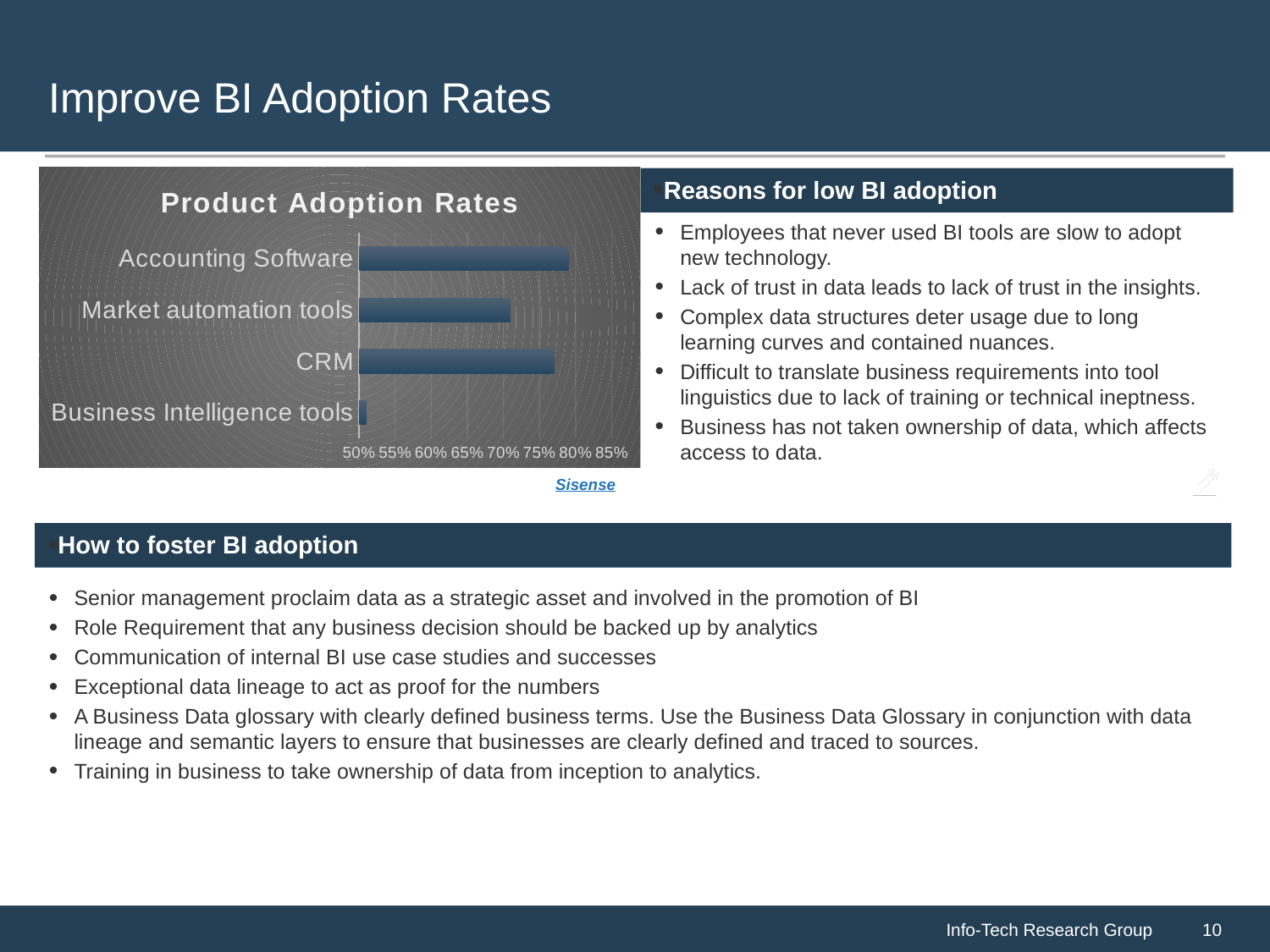
Is the value for Market automation tools greater or less than 75%? less Which category has the lowest adoption rate in the Product Adoption Rates chart? Business Intelligence tools How many product categories are plotted in the Product Adoption Rates chart? 4 What is the title of the chart on the slide? Product Adoption Rates What type of chart is shown under the title "Product Adoption Rates"? bar chart Which has a higher adoption rate, CRM or Market automation tools? CRM Is the value for CRM greater or less than 70%? greater Which has a higher adoption rate, Market automation tools or Accounting Software? Accounting Software Is the value for Business Intelligence tools greater or less than 55%? less What is the highest value shown on the horizontal axis of the Product Adoption Rates chart? 85% Which has a higher adoption rate, Accounting Software or Business Intelligence tools? Accounting Software